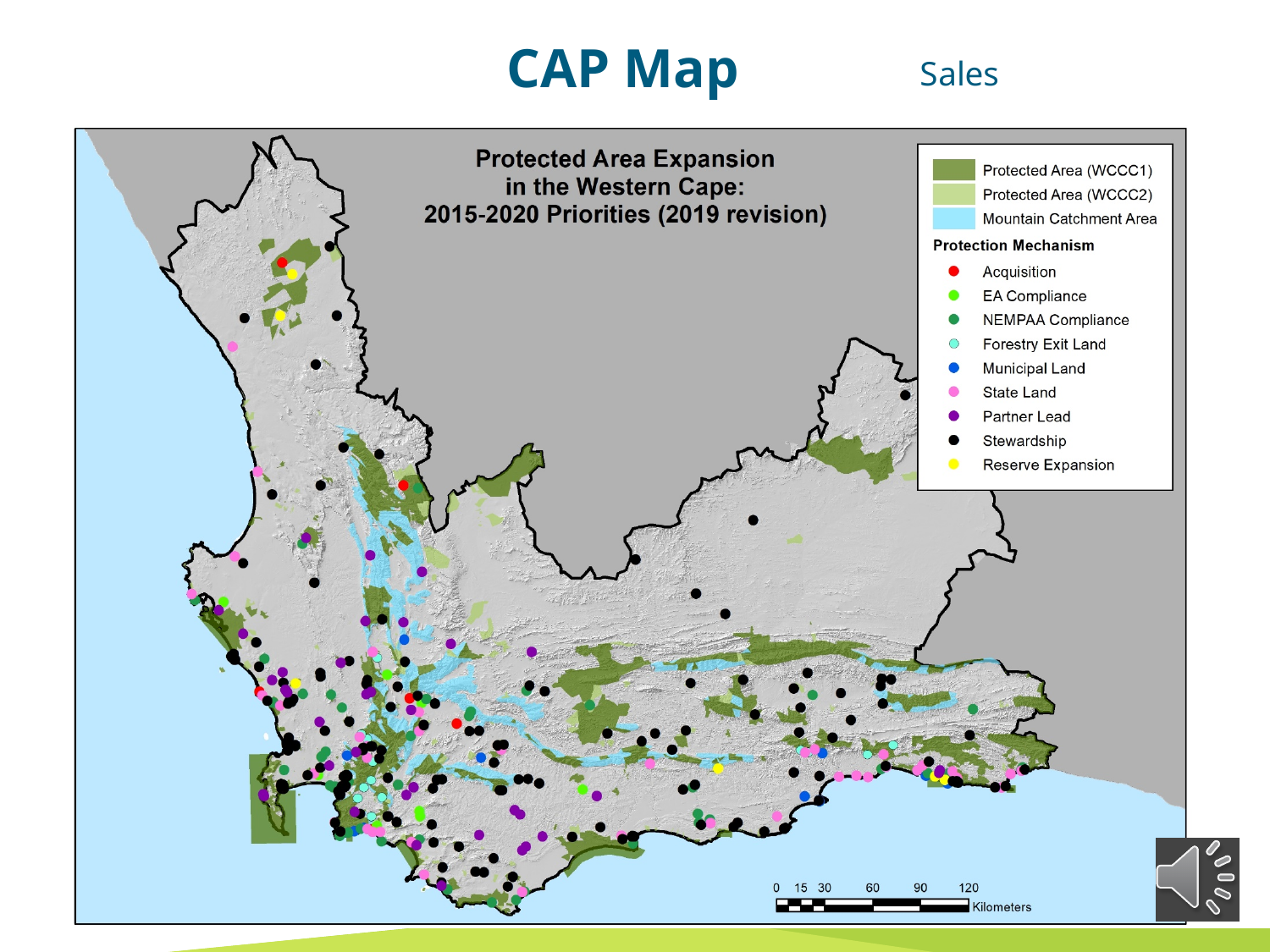
How many protection mechanisms does the map legend list? 9 What kind of graphic is shown on the slide? A map What is the title printed on the map? Protected Area Expansion in the Western Cape: 2015-2020 Priorities (2019 revision) What is the largest distance labelled on the map's scale bar? 120 Kilometers What colour marks the Acquisition protection mechanism in the legend? Red How many area types (shaded regions) are listed in the map legend above the protection mechanisms? 3